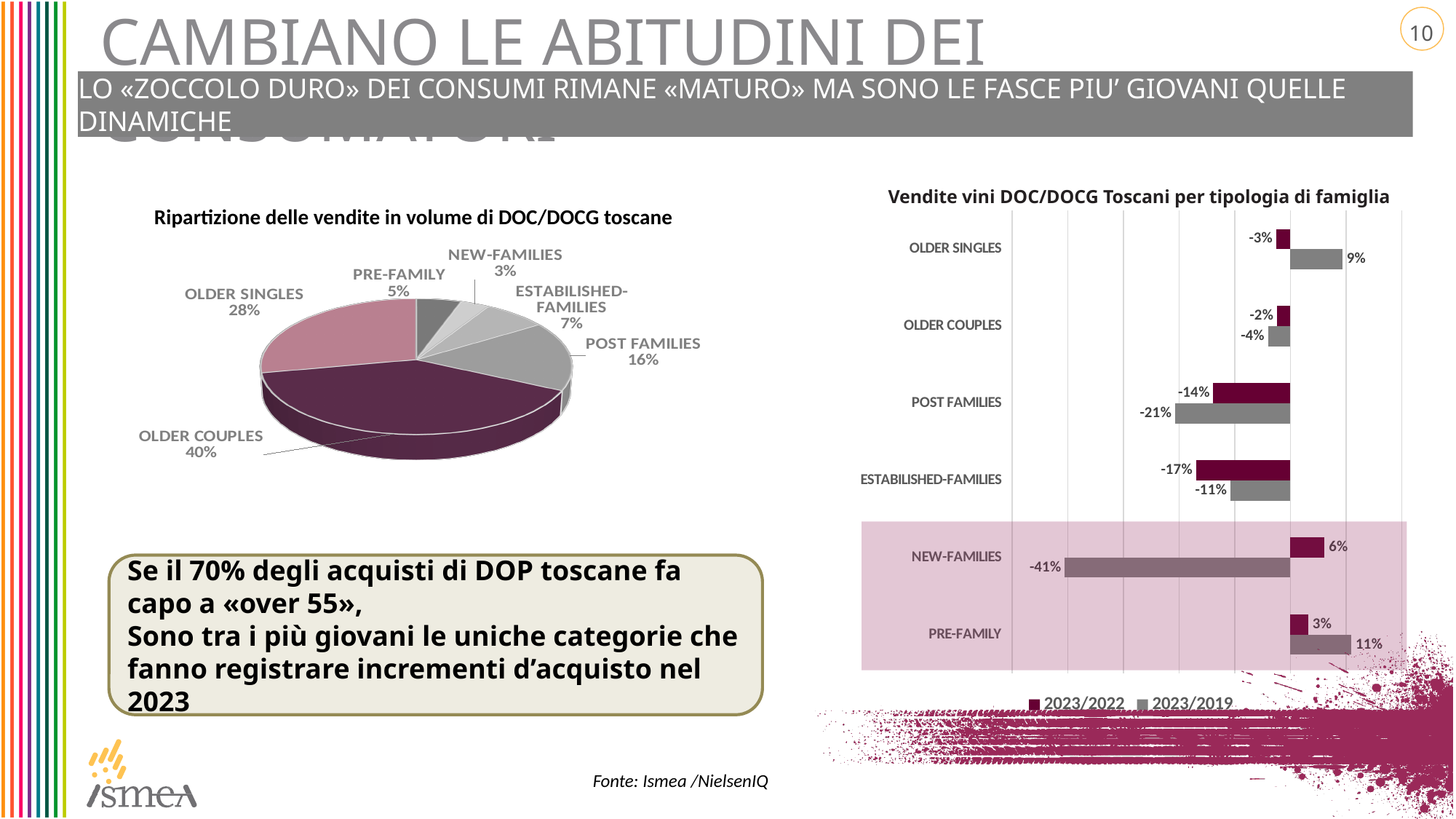
In the pie chart 'Ripartizione delle vendite in volume di DOC/DOCG toscane', what share do OLDER COUPLES hold? 40% In the pie chart 'Ripartizione delle vendite in volume di DOC/DOCG toscane', what is the difference between the OLDER SINGLES share and the POST FAMILIES share? 12% In the chart 'Vendite vini DOC/DOCG Toscani per tipologia di famiglia', what is the 2023/2022 value for ESTABILISHED-FAMILIES? -17% In the chart 'Vendite vini DOC/DOCG Toscani per tipologia di famiglia', what is the 2023/2019 value for NEW-FAMILIES? -41% What kind of chart is 'Vendite vini DOC/DOCG Toscani per tipologia di famiglia'? Bar chart In the pie chart 'Ripartizione delle vendite in volume di DOC/DOCG toscane', which category has the smallest slice? NEW-FAMILIES In the chart 'Vendite vini DOC/DOCG Toscani per tipologia di famiglia', which is larger for POST FAMILIES: the 2023/2022 value or the 2023/2019 value? 2023/2022 In the chart 'Vendite vini DOC/DOCG Toscani per tipologia di famiglia', which category has the highest 2023/2019 value? PRE-FAMILY In the pie chart 'Ripartizione delle vendite in volume di DOC/DOCG toscane', how many slices are there? 6 In the chart 'Vendite vini DOC/DOCG Toscani per tipologia di famiglia', how many series does the legend list? 2 In the chart 'Vendite vini DOC/DOCG Toscani per tipologia di famiglia', what is the difference between the 2023/2019 value for OLDER SINGLES and the 2023/2019 value for OLDER COUPLES? 13% In the pie chart 'Ripartizione delle vendite in volume di DOC/DOCG toscane', what share do ESTABILISHED-FAMILIES hold? 7%